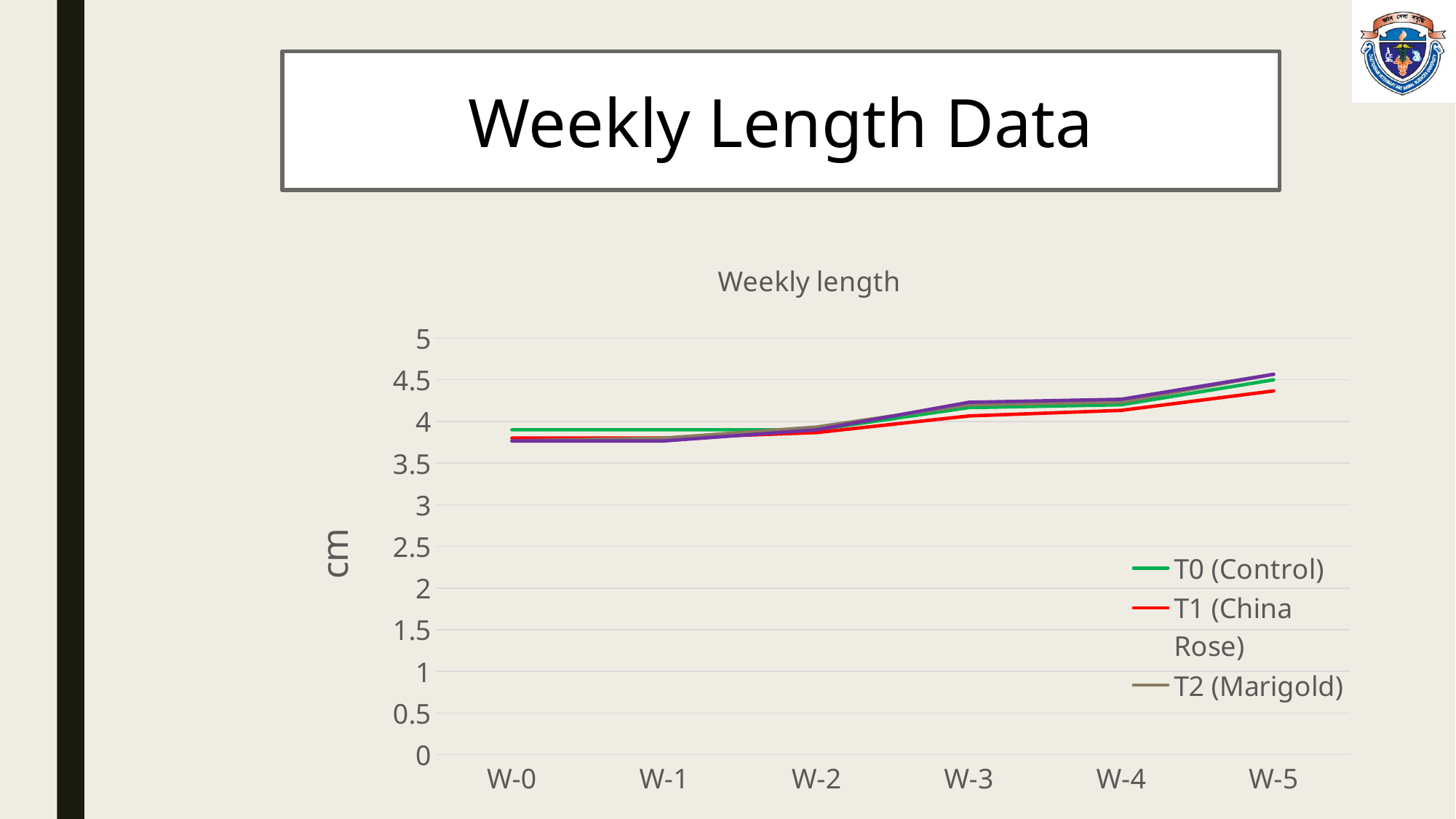
At W-5, which is larger, the value for T0 (Control) or T1 (China Rose)? T0 (Control) What is the title of the chart? Weekly length Is the value for T0 (Control) at W-3 greater or less than 4? greater What kind of chart is shown on the slide? line chart Is the value for T1 (China Rose) at W-0 greater or less than 4? less Is the value for T0 (Control) at W-5 greater or less than 5? less How many week categories are shown on the x axis? 6 Which series has the lowest value at W-5? T1 (China Rose) How many series does the legend list? 3 What is the label on the vertical axis of the chart? cm Do the length values rise or fall from W-0 to W-5? rise